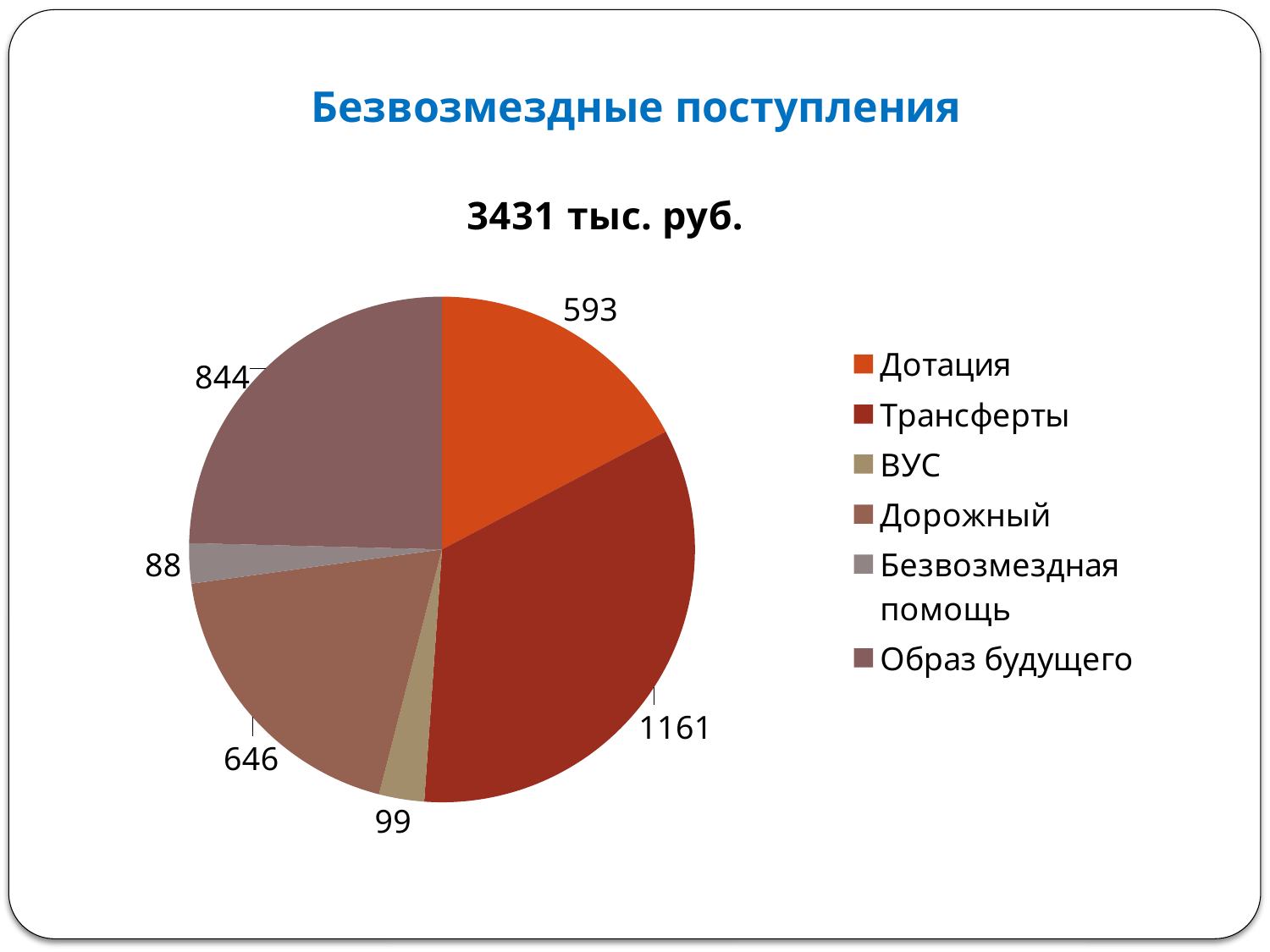
Which is larger, Образ будущего or Дорожный? Образ будущего What is the chart title shown above the pie? 3431 тыс. руб. What type of chart is shown on the slide? pie chart Which category has the smallest slice? Безвозмездная помощь What is the value for Образ будущего? 844 What is the value for Безвозмездная помощь? 88 What is the value for Дотация? 593 What is the difference between the values for Трансферты and Дорожный? 515 What is the difference between the values for ВУС and Безвозмездная помощь? 11 How many categories does the legend list? 6 What is the value for Трансферты? 1161 Which category has the largest slice? Трансферты